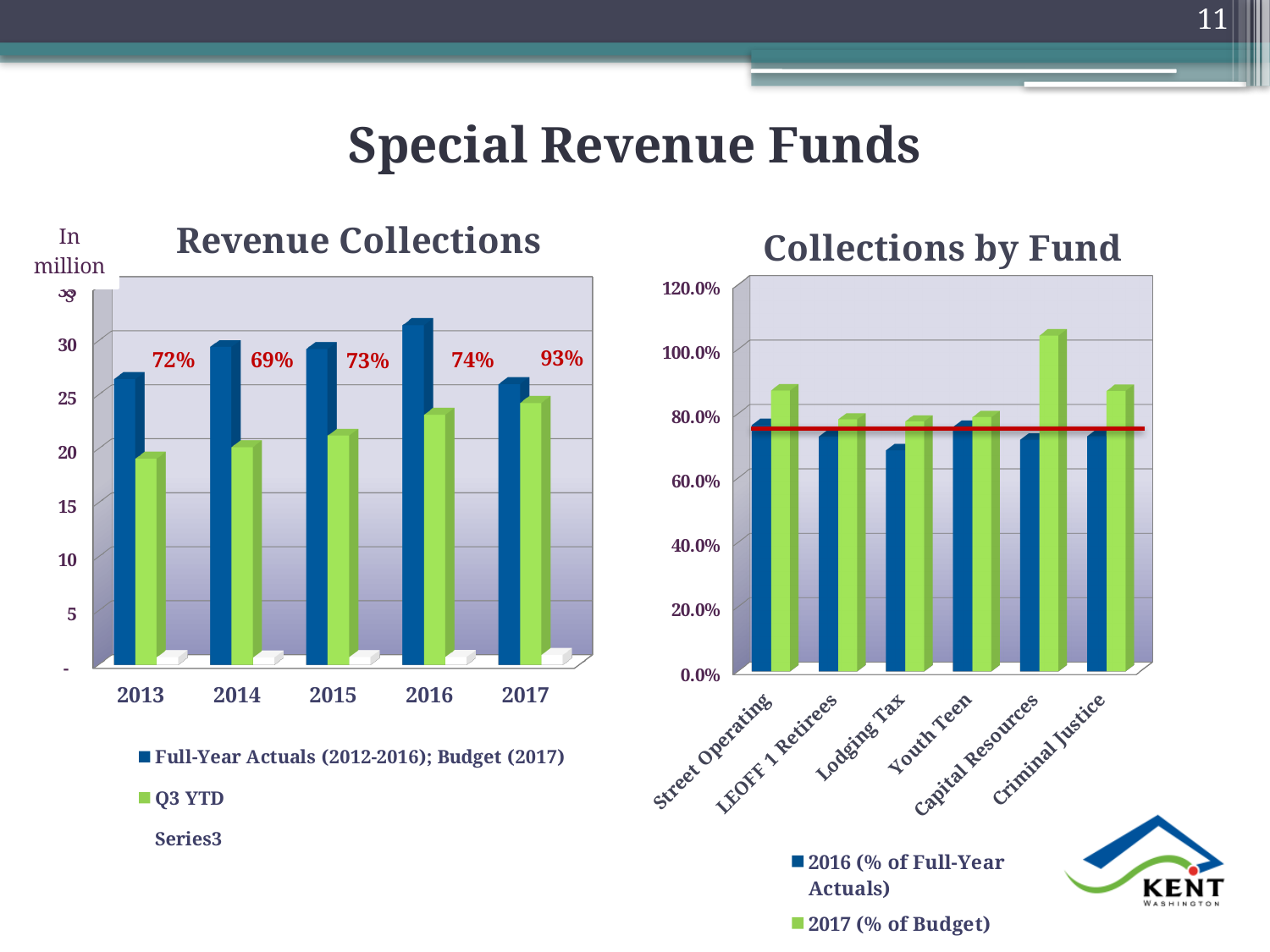
In the Revenue Collections chart, what percentage label is shown above the 2017 bars? 93% In the Revenue Collections chart, what percentage label is shown above the 2013 bars? 72% In the Revenue Collections chart, is the Full-Year Actuals value for 2016 greater or less than 30? greater In the Revenue Collections chart, how many years are shown on the x axis? 5 In the Collections by Fund chart, which fund has the highest 2017 (% of Budget) value? Capital Resources In the Revenue Collections chart, which year has the lowest percentage label? 2014 In the Collections by Fund chart, how many funds are shown on the x axis? 6 In the Revenue Collections chart, what is the difference between the percentage labels for 2017 and 2016? 19% In the Collections by Fund chart, is the 2017 (% of Budget) value for Capital Resources greater or less than 100.0%? greater In the Revenue Collections chart, which is larger: the Full-Year Actuals bar for 2016 or for 2017? 2016 In the Revenue Collections chart, which year has the highest percentage label? 2017 In the Revenue Collections chart, how many entries does the legend list? 3